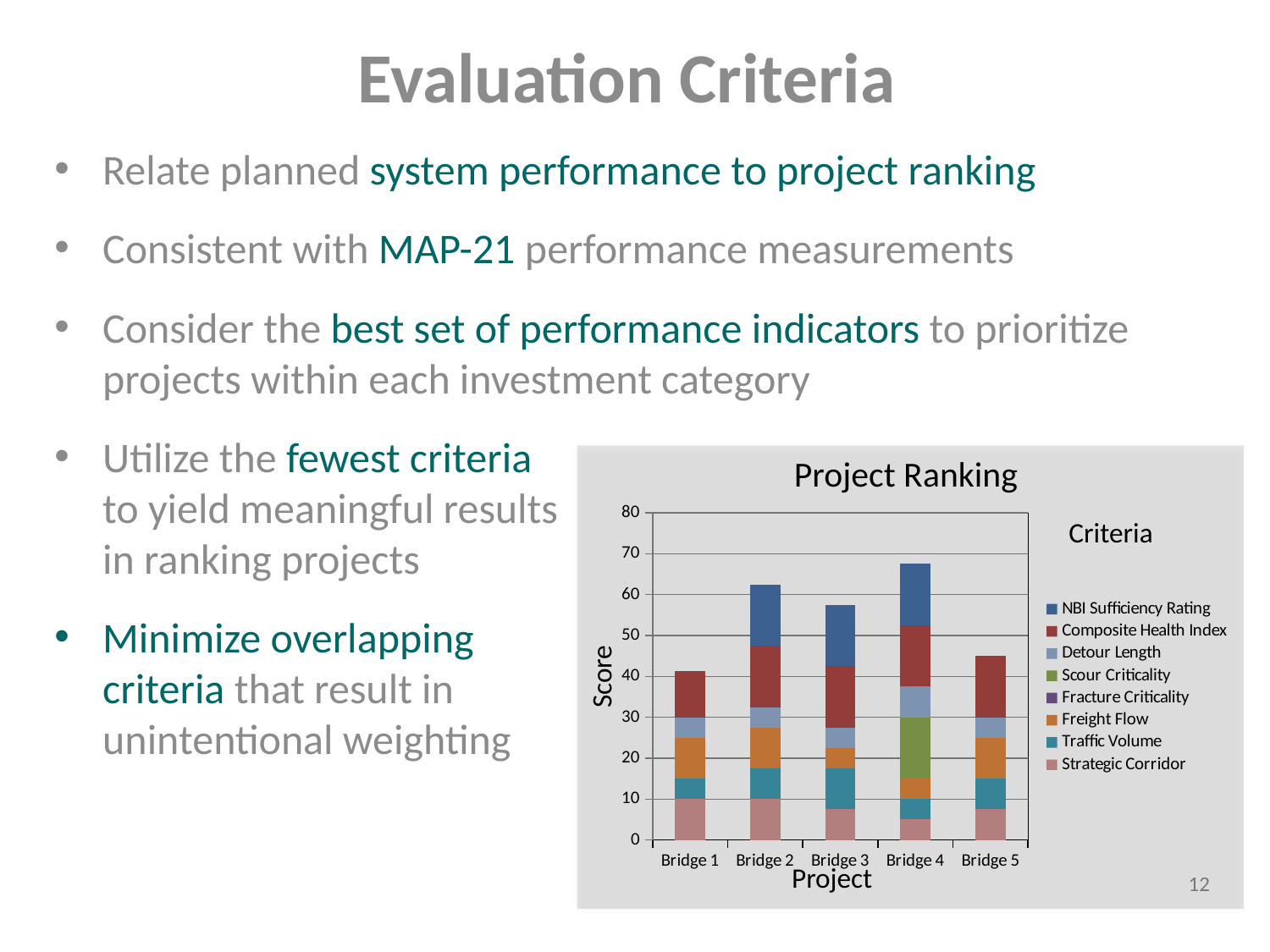
What is the label of the y axis of the chart? Score How many criteria does the chart legend list? 8 How many projects (bars) are shown on the x axis of the chart? 5 Is the total score for Bridge 4 greater or less than 60? greater Which has the larger total score, Bridge 2 or Bridge 3? Bridge 2 Is the total score for Bridge 1 greater or less than 50? less What kind of chart is shown on the slide? Stacked bar chart What is the title of the chart? Project Ranking Is the total score for Bridge 5 greater or less than 50? less Which project has the highest total score in the chart? Bridge 4 Which project has the lowest total score in the chart? Bridge 1